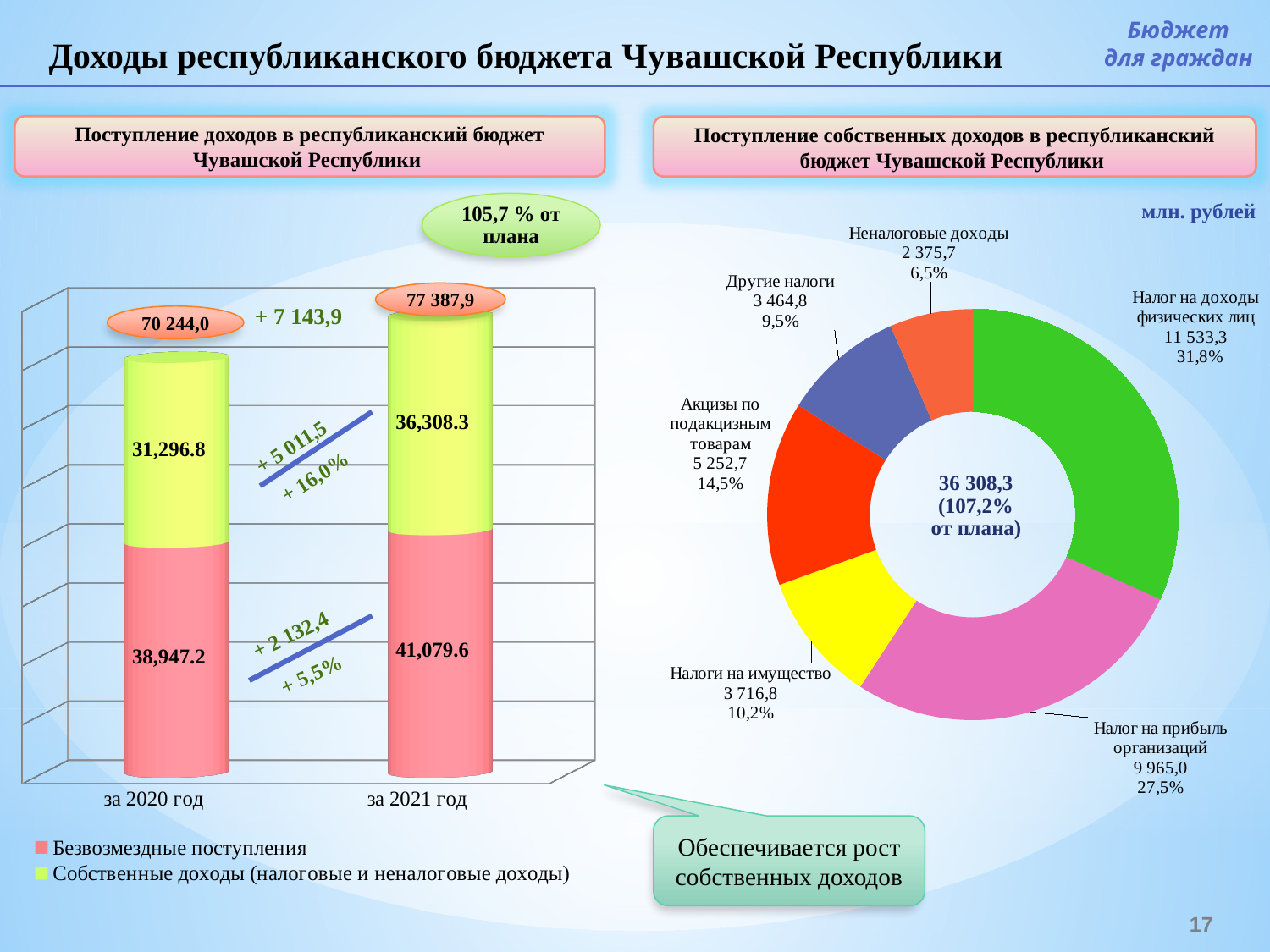
In the left bar chart, what is the difference between the total for за 2021 год and the total for за 2020 год? 7 143,9 In the left bar chart, what is the total of the stacked bar for за 2021 год? 77 387,9 In the right donut chart, what share does Налог на прибыль организаций have? 27,5% In the left bar chart, what is the value of Собственные доходы for за 2020 год? 31,296.8 How many categories are shown in the right donut chart (Поступление собственных доходов в республиканский бюджет Чувашской Республики)? 6 In the left bar chart (Поступление доходов в республиканский бюджет Чувашской Республики), what is the value of Безвозмездные поступления for за 2021 год? 41,079.6 In the right donut chart, which category has the largest value? Налог на доходы физических лиц In the right donut chart, which category has the smallest value? Неналоговые доходы How many series does the legend of the left bar chart list? 2 What kind of chart is the left chart on the slide? Stacked bar chart In the right donut chart, what is the value for Акцизы по подакцизным товарам? 5 252,7 In the left bar chart, which year has the larger value for Безвозмездные поступления, за 2020 год or за 2021 год? за 2021 год